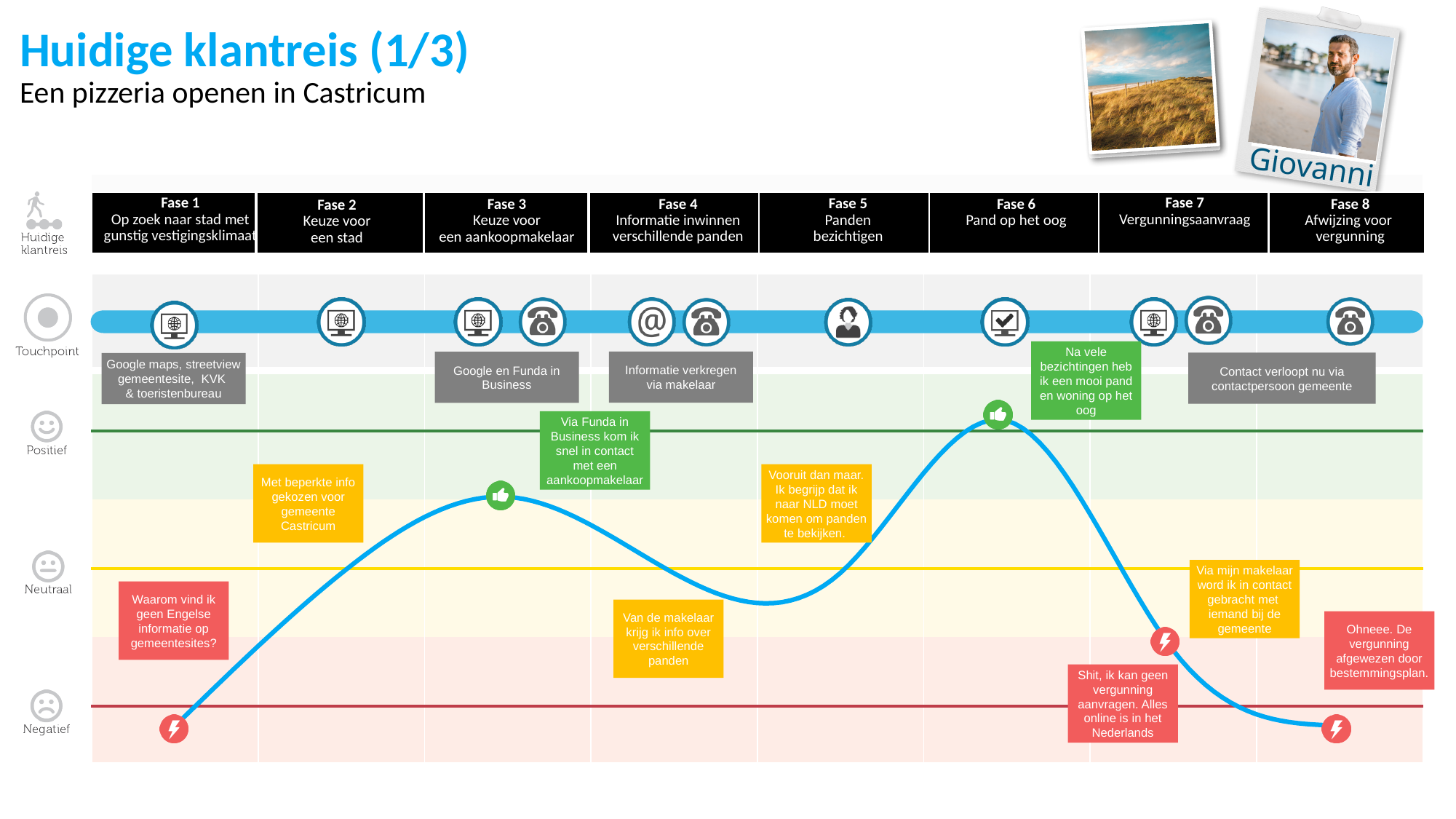
Does the emotion line rise or fall from Fase 1 to Fase 3? rise How many emotion levels are labelled on the left axis of the journey map? 3 (Positief, Neutraal, Negatief) Does the emotion line rise or fall from Fase 6 to Fase 8? fall What is the name of the persona shown in the photo at the top right? Giovanni Is the peak of the emotion line in Fase 6 above or below the Positief line? above Is the peak of the emotion line in Fase 3 above or below the Neutraal line? above In which phase does the emotion line reach its highest point? Fase 6 (Pand op het oog) What kind of chart is used to show the customer's emotional journey across the phases? line chart Which is lower on the emotion line: the point in Fase 1 or the low point in Fase 7? Fase 1 What is the title of the slide? Huidige klantreis (1/3) How many phases (Fase) are shown along the top of the journey map? 8 Which is higher on the emotion line: the peak in Fase 3 or the peak in Fase 6? Fase 6